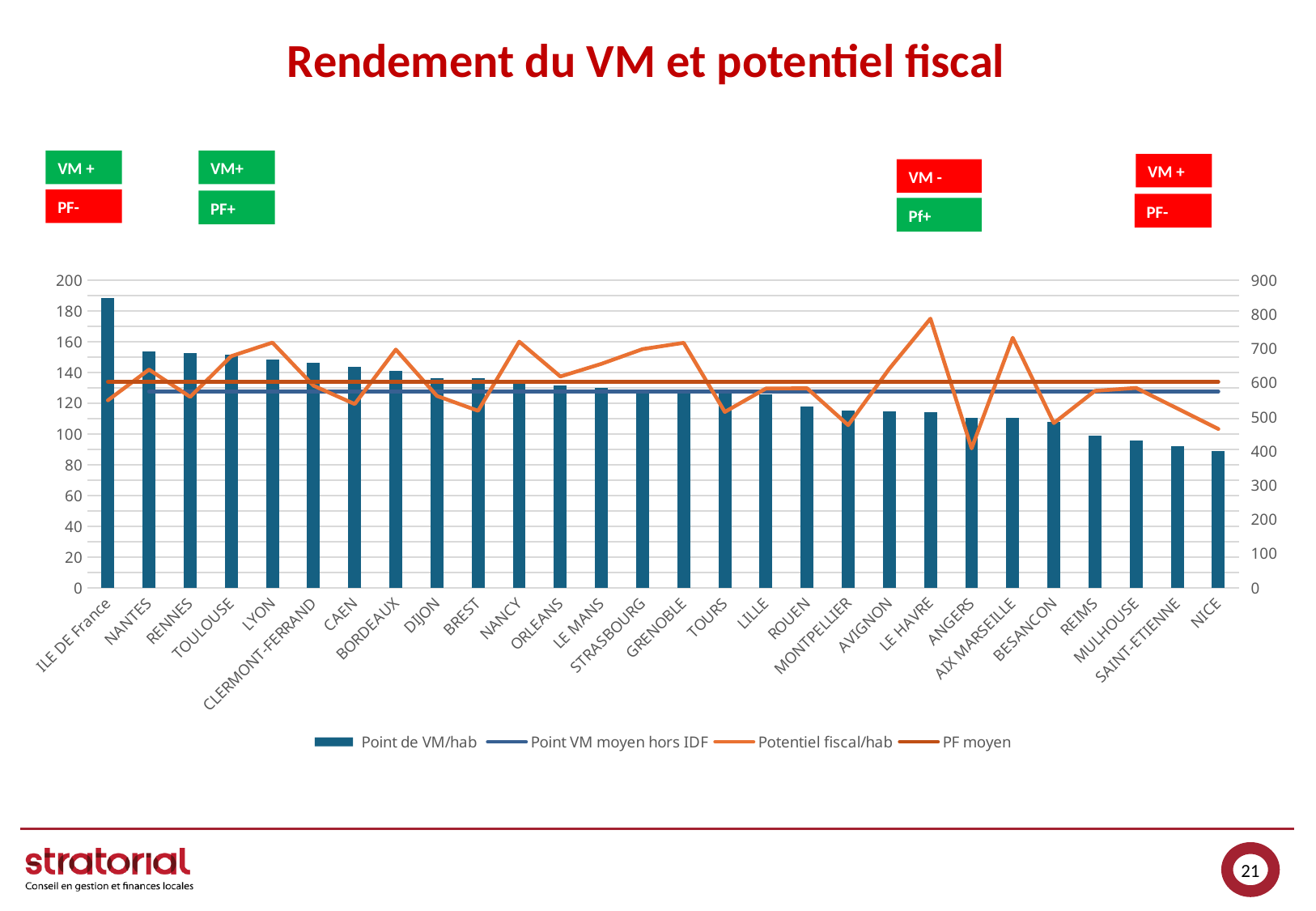
Which has the larger Point de VM/hab bar, NANTES or NICE? NANTES Which category has the lowest bar for Point de VM/hab? NICE How many cities/categories are shown on the x axis of the chart? 28 What is the title of the slide containing the chart? Rendement du VM et potentiel fiscal Is the Point de VM/hab value for NICE greater or less than 100? less Is the Potentiel fiscal/hab value for LE HAVRE greater or less than 700? greater What kind of chart is shown on the slide? A bar chart combined with line series How many series does the chart legend list? 4 Is the Point de VM/hab value for ILE DE France greater or less than 180? greater Which category has the highest bar for Point de VM/hab? ILE DE France Do the Point de VM/hab bars generally rise or fall from left to right along the x axis? Fall Which has the larger Potentiel fiscal/hab value, LE HAVRE or ANGERS? LE HAVRE